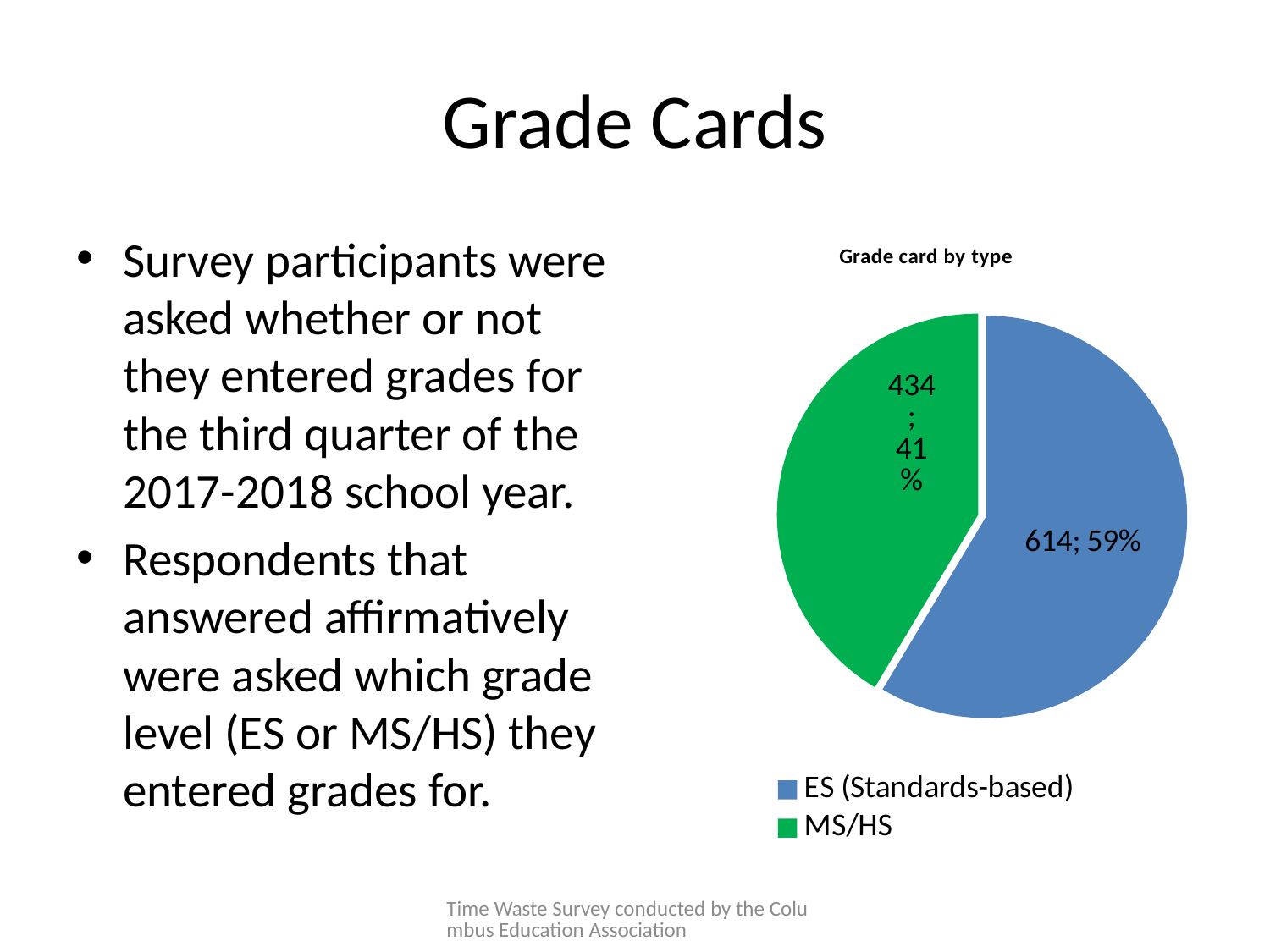
What share of the pie does MS/HS represent? 41% What is the value for ES (Standards-based)? 614 What is the title of the chart? Grade card by type Which colour represents MS/HS in the pie chart? green What type of chart is shown on the slide? pie chart What is the value for MS/HS? 434 How many slices does the pie chart have? 2 Which category has the smallest slice? MS/HS What share of the pie does ES (Standards-based) represent? 59% Which category has the largest slice? ES (Standards-based) What is the difference between the ES (Standards-based) value and the MS/HS value? 180 How many entries does the legend list? 2